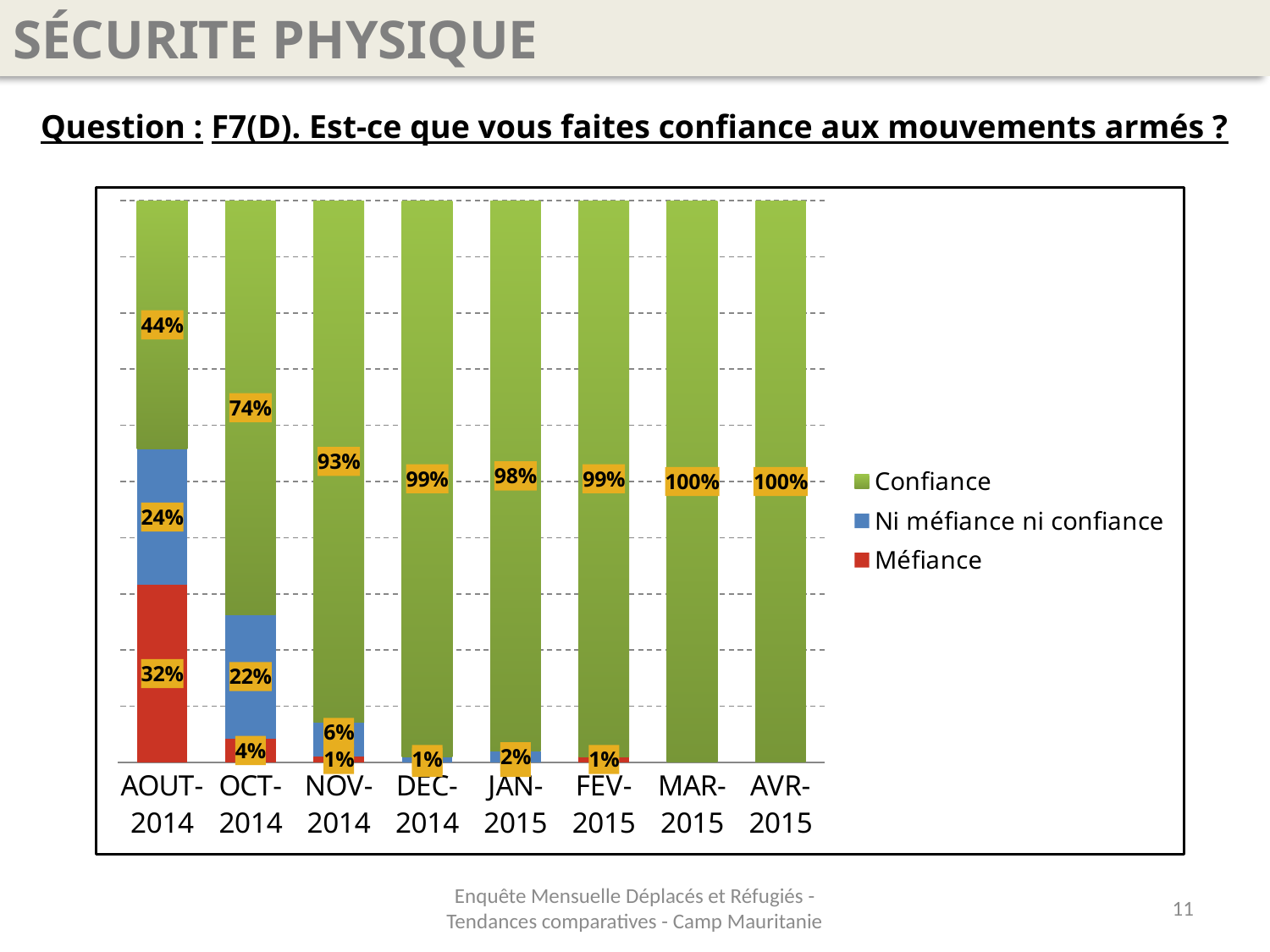
How many series does the legend list? 3 What is the Méfiance value for AOUT-2014? 32% What is the Confiance value for NOV-2014? 93% What is the difference between the Confiance values for OCT-2014 and AOUT-2014? 30% What is the Confiance value for AOUT-2014? 44% Which series is shown in red in the legend? Méfiance Does the Confiance value generally rise or fall from AOUT-2014 to AVR-2015? rise How many months (categories) are shown on the x axis? 8 Which months show a Confiance value of 100%? MAR-2015 and AVR-2015 Which month has the lowest Confiance value? AOUT-2014 What type of chart is shown on the slide? stacked bar chart What is the Ni méfiance ni confiance value for OCT-2014? 22%